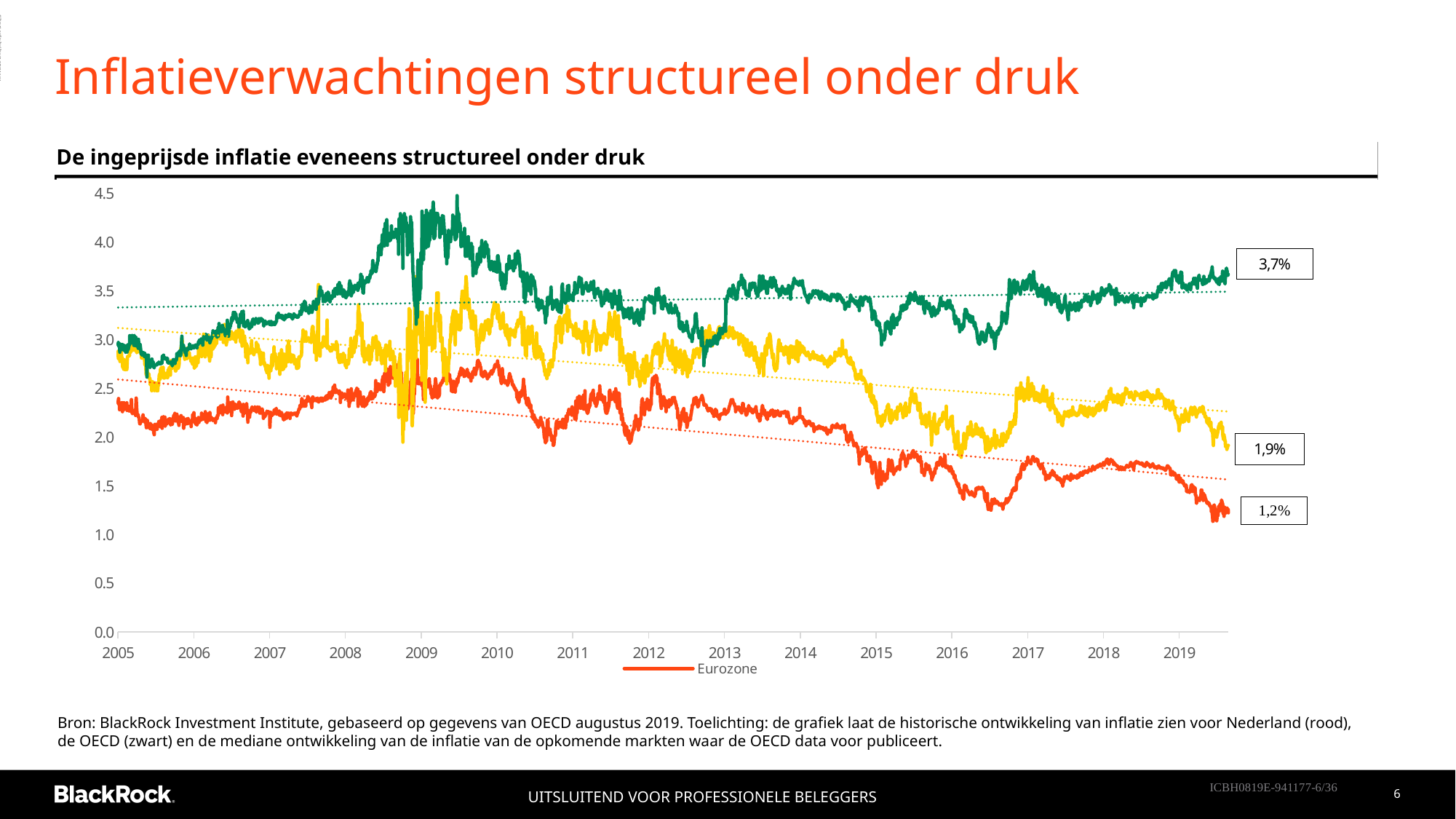
What value is labelled at the end of the orange Eurozone line? 1,2% What value is labelled at the end of the green line? 3,7% Which line ends at the lowest labelled value? The orange Eurozone line (1,2%) What is the title of the chart? De ingeprijsde inflatie eveneens structureel onder druk How many series does the legend list? 1 What is the difference between the end labels of the green line and the orange Eurozone line? 2,5% Is the end value of the yellow line (1,9%) larger or smaller than the end value of the orange line (1,2%)? Larger Is the peak of the green line around 2009 greater or less than 4.0? greater What value is labelled at the end of the yellow line? 1,9% Does the orange Eurozone line generally rise or fall from 2005 to 2019? Fall Which line ends at the highest labelled value? The green line (3,7%) What kind of chart is shown on the slide? Line chart